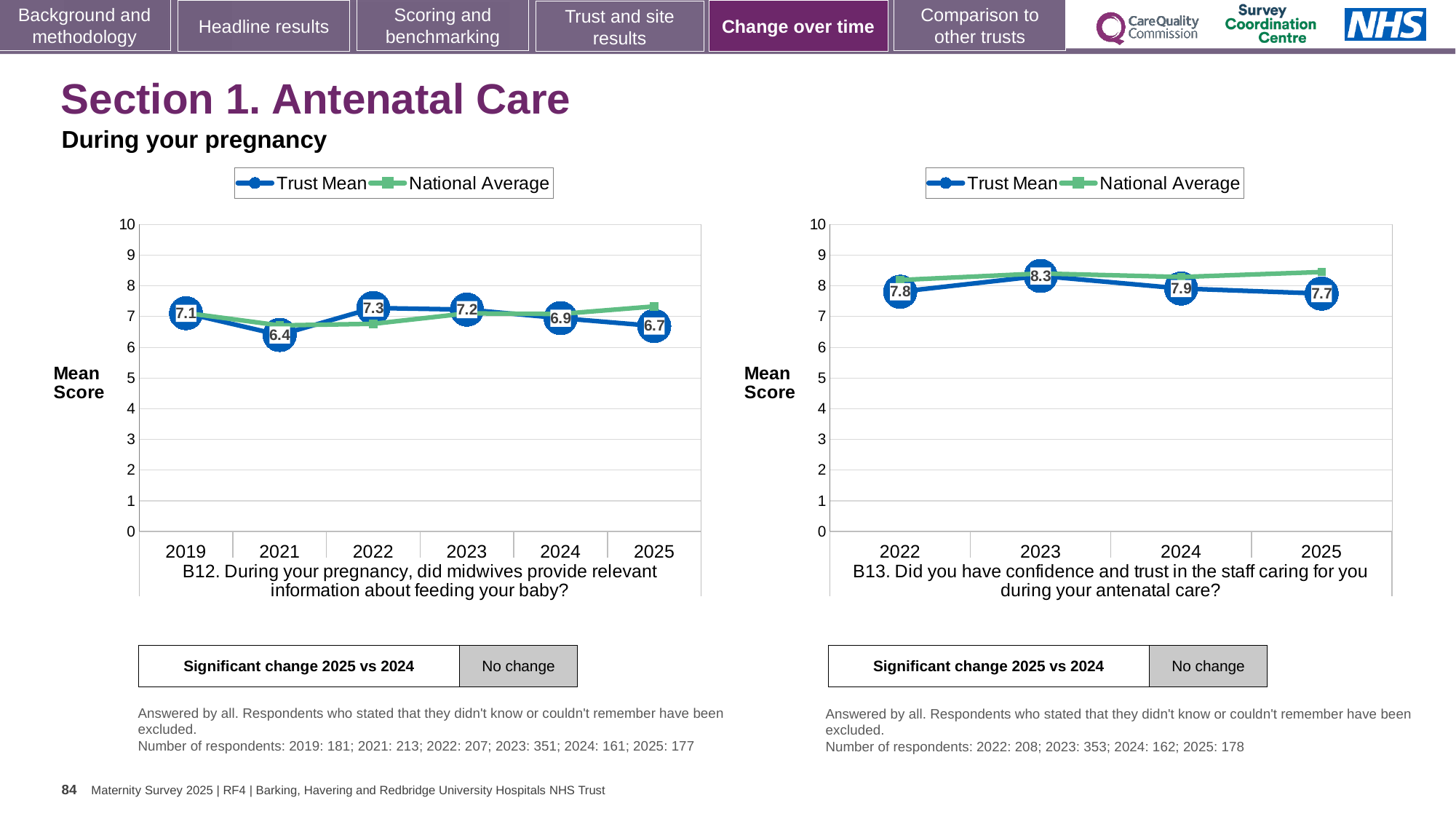
In the B13 chart (right), is the Trust Mean score higher in 2022 or in 2024? 2024 In the B13 chart (right), what is the difference between the Trust Mean scores for 2023 and 2025? 0.6 In the B12 chart (left), what is the Trust Mean score for 2021? 6.4 In the B12 chart (left), what is the Trust Mean score for 2025? 6.7 How many series does the legend of the B13 chart (right) list? 2 In the B12 chart (left), which year has the highest Trust Mean score? 2022 In the B12 chart (left), what is the difference between the Trust Mean scores for 2022 and 2021? 0.9 What type of chart is the B12 chart (left)? Line chart In the B13 chart (right), which year has the lowest Trust Mean score? 2025 How many years are plotted on the x axis of the B12 chart (left)? 6 In the B13 chart (right), is the National Average value for 2025 greater or less than 8? greater In the B13 chart (right), what is the Trust Mean score for 2023? 8.3